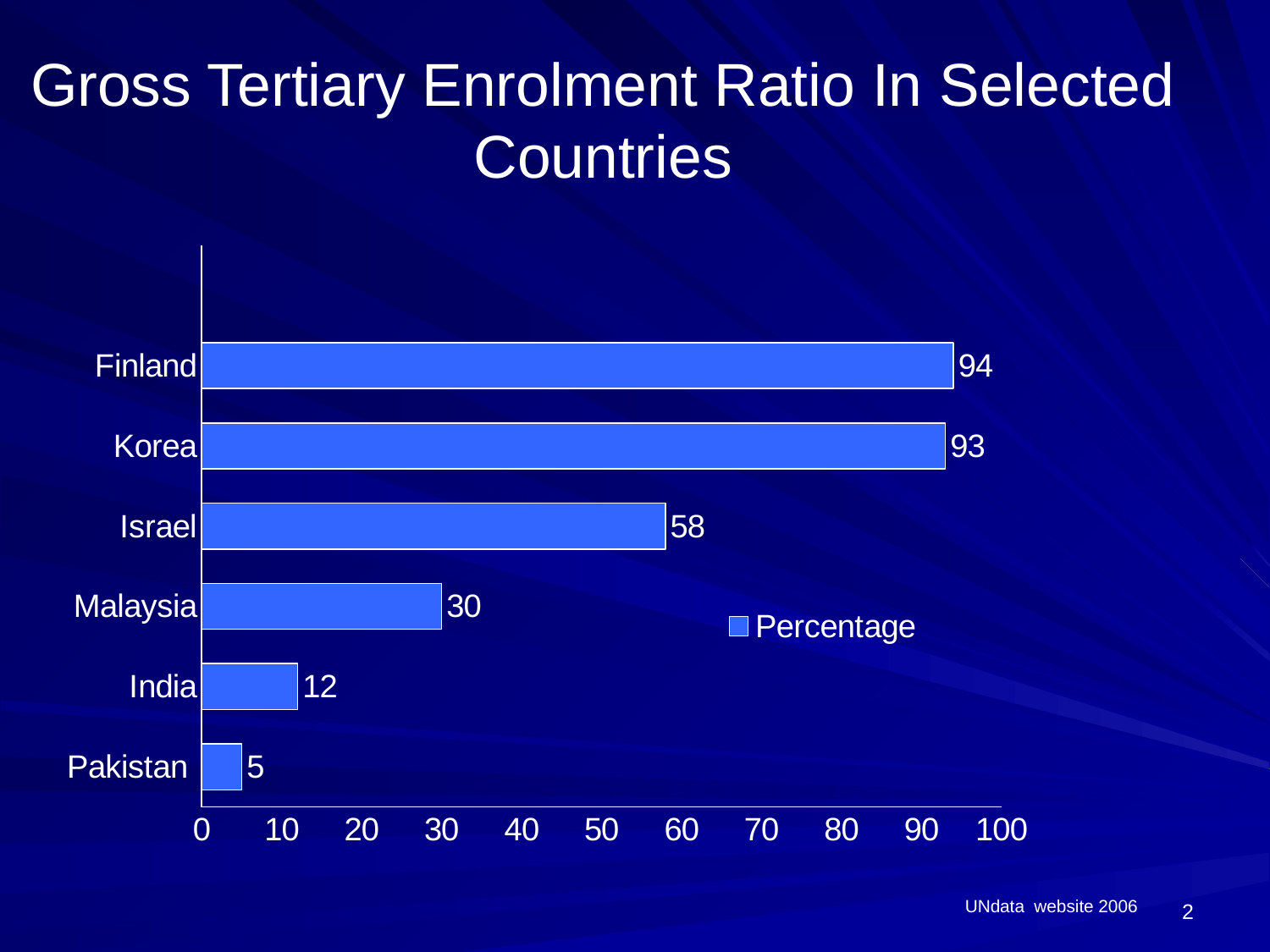
Which has a larger value, Malaysia or India? Malaysia What is the difference between the values for Israel and Malaysia? 28 What is the value for Israel? 58 What kind of chart is shown on the slide? Bar chart What is the value for India? 12 What is the difference between the values for Finland and Korea? 1 Is the value for Israel greater or less than 50? greater Which country has the highest value? Finland How many series does the legend list? 1 How many countries are shown in the chart? 6 What is the value for Finland? 94 Which country has the lowest value? Pakistan